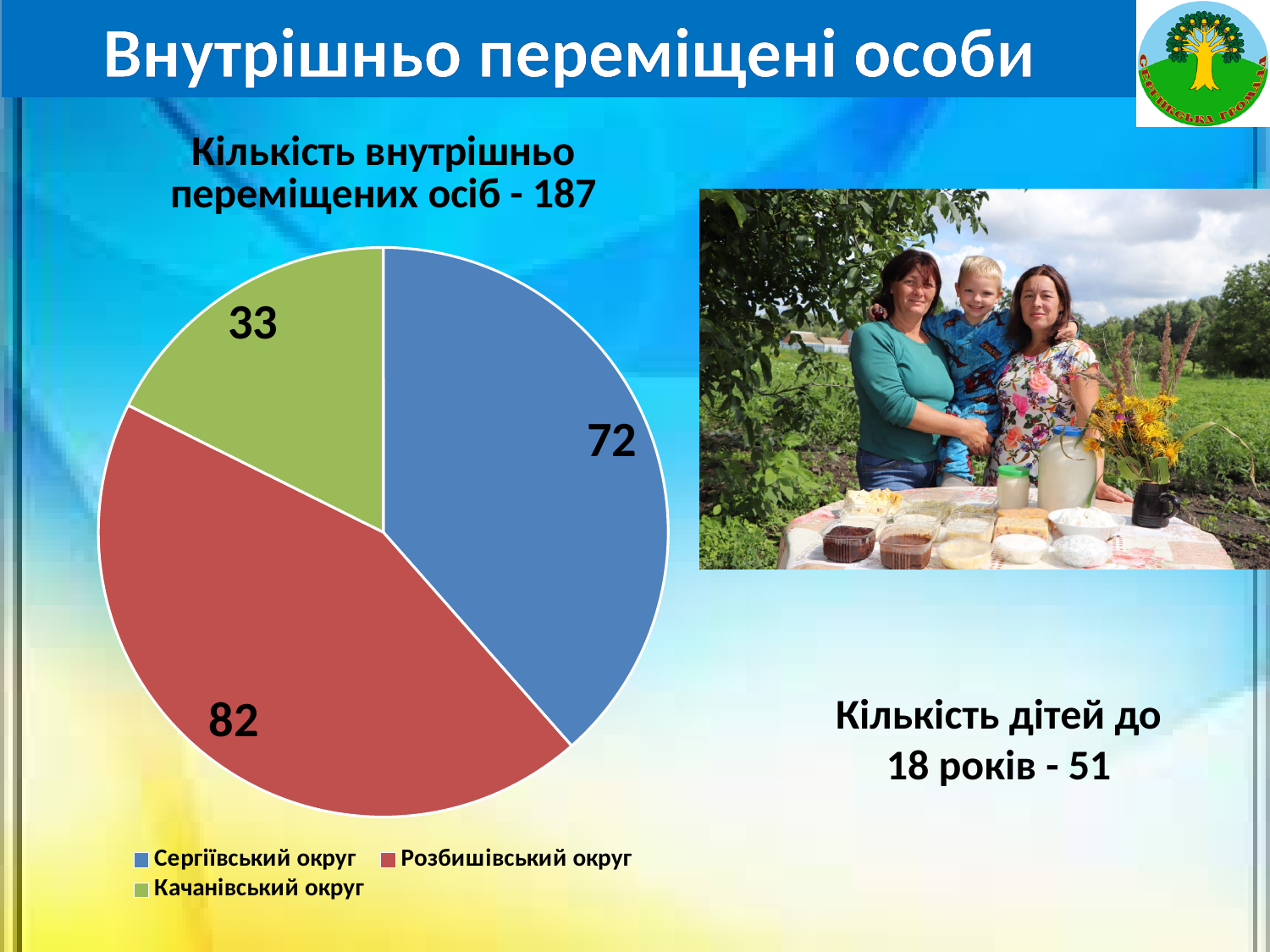
What is the difference between the values for Сергіївський округ and Качанівський округ? 39 Which district has the largest slice in the pie chart? Розбишівський округ What is the value for Розбишівський округ in the pie chart? 82 What kind of chart is shown on the slide? Pie chart Which district has the smallest slice in the pie chart? Качанівський округ How many slices does the pie chart have? 3 What is the value for Качанівський округ in the pie chart? 33 What colour is the slice for Розбишівський округ? Red What is the total of all slices in the pie chart? 187 What is the difference between the values for Розбишівський округ and Сергіївський округ? 10 What is the value for Сергіївський округ in the pie chart? 72 Which is larger, the value for Сергіївський округ or Качанівський округ? Сергіївський округ